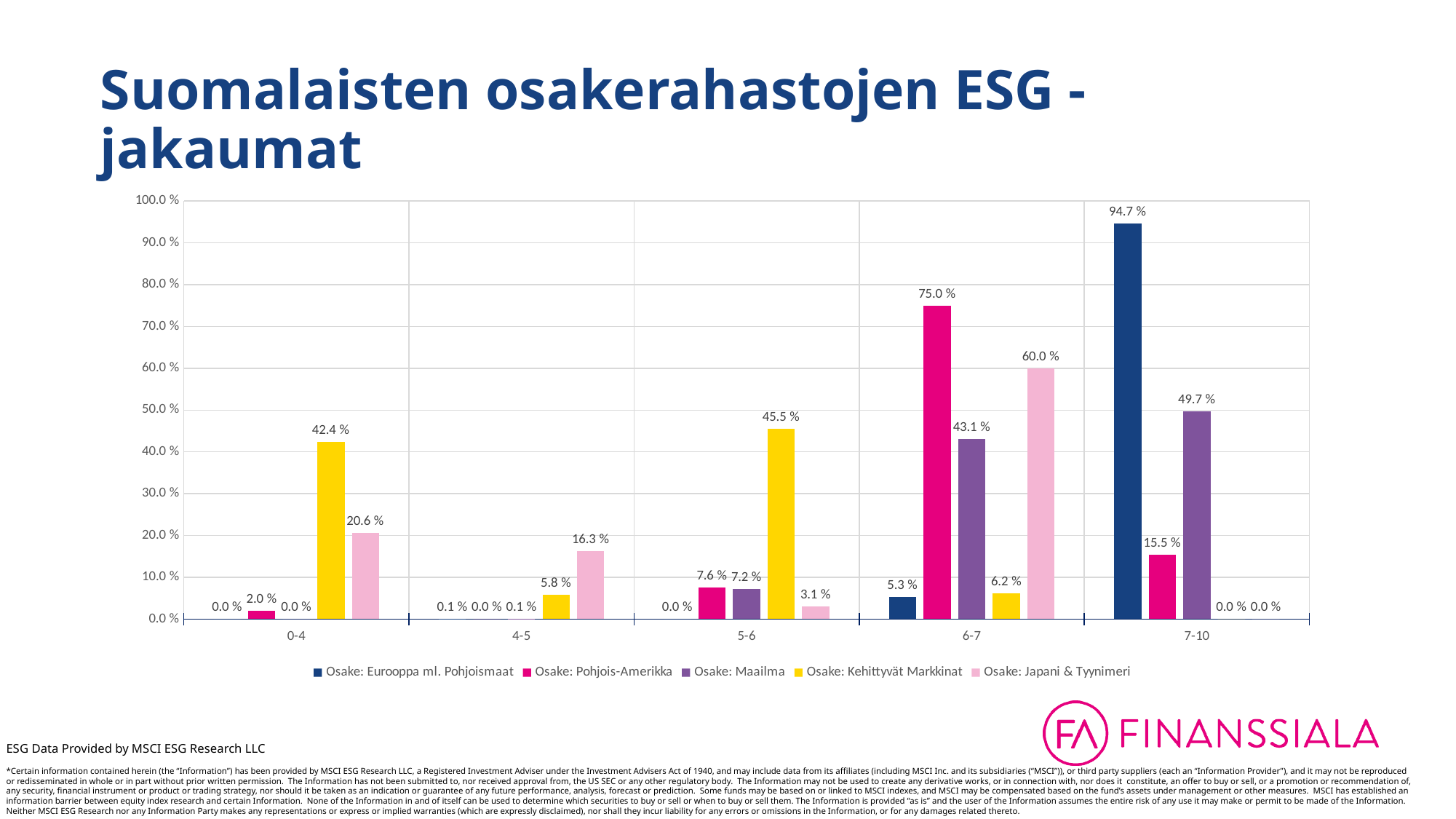
How many categories are shown on the x axis? 5 What is the value for Osake: Japani & Tyynimeri in the 6-7 category? 60.0 % Do the values for Osake: Eurooppa ml. Pohjoismaat rise or fall from the 6-7 category to the 7-10 category? Rise How many series does the legend list? 5 In which category does Osake: Pohjois-Amerikka have its highest value? 6-7 What is the difference between Osake: Pohjois-Amerikka and Osake: Maailma in the 6-7 category? 31.9 % What is the value for Osake: Eurooppa ml. Pohjoismaat in the 7-10 category? 94.7 % What kind of chart is shown on the slide? Bar chart Which is larger in the 5-6 category: Osake: Pohjois-Amerikka or Osake: Kehittyvät Markkinat? Osake: Kehittyvät Markkinat What is the value for Osake: Kehittyvät Markkinat in the 0-4 category? 42.4 % In which category does Osake: Japani & Tyynimeri have its lowest value? 7-10 What is the value for Osake: Maailma in the 7-10 category? 49.7 %